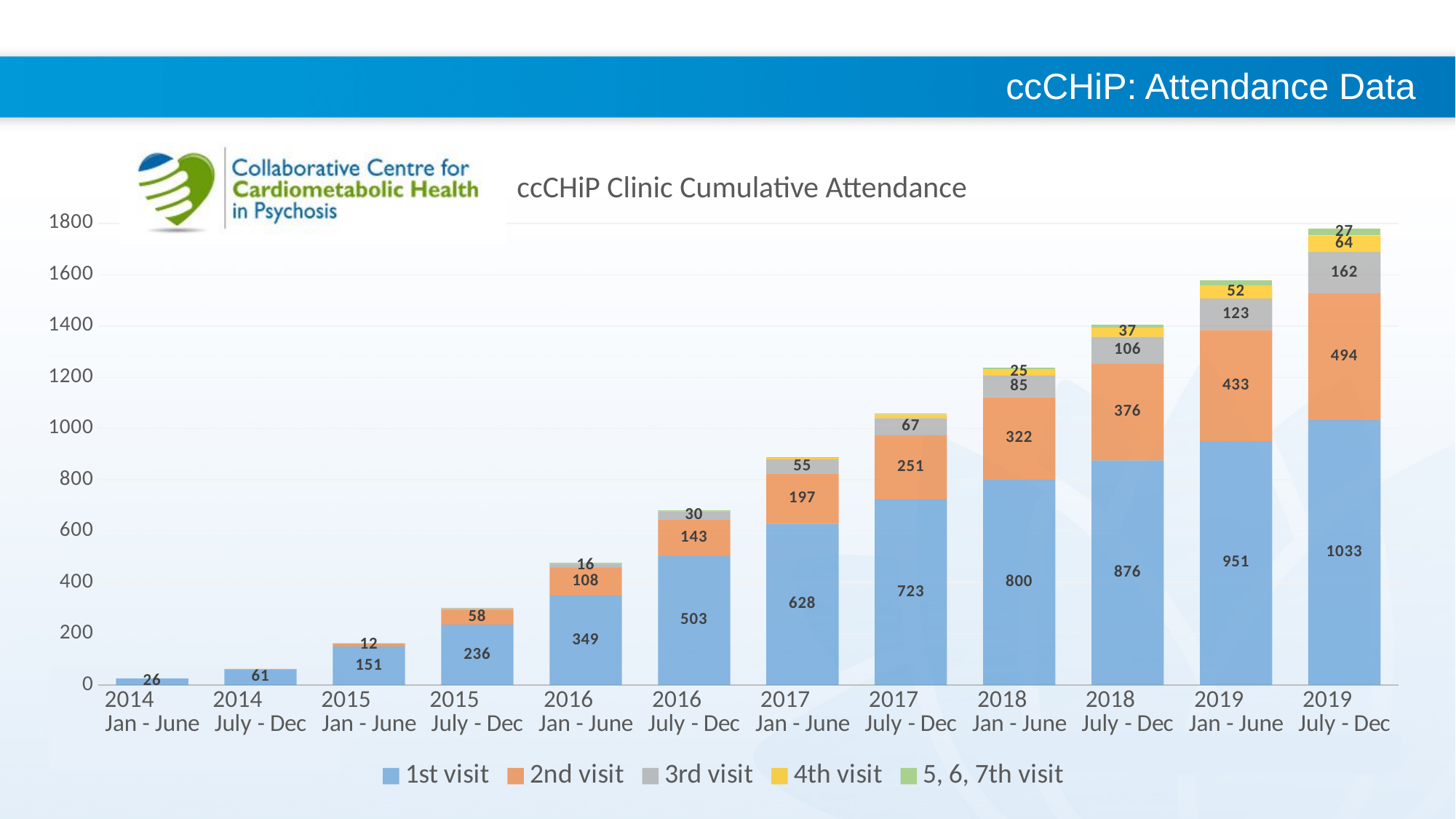
What is the title of the chart? ccCHiP Clinic Cumulative Attendance What is the 3rd visit value for 2017 July - Dec? 67 Is the total bar for 2017 Jan - June greater or less than 800? greater What is the 2nd visit value for 2018 Jan - June? 322 Do the 1st visit values rise or fall from 2014 Jan - June to 2019 July - Dec? rise What is the 1st visit value for 2019 July - Dec? 1033 What kind of chart is shown on the slide? Stacked bar chart What is the 4th visit value for 2019 Jan - June? 52 How many time periods are shown on the x axis? 12 What is the difference between the 1st visit values for 2019 July - Dec and 2019 Jan - June? 82 How many series does the legend list? 5 Which period has the lowest 1st visit value? 2014 Jan - June